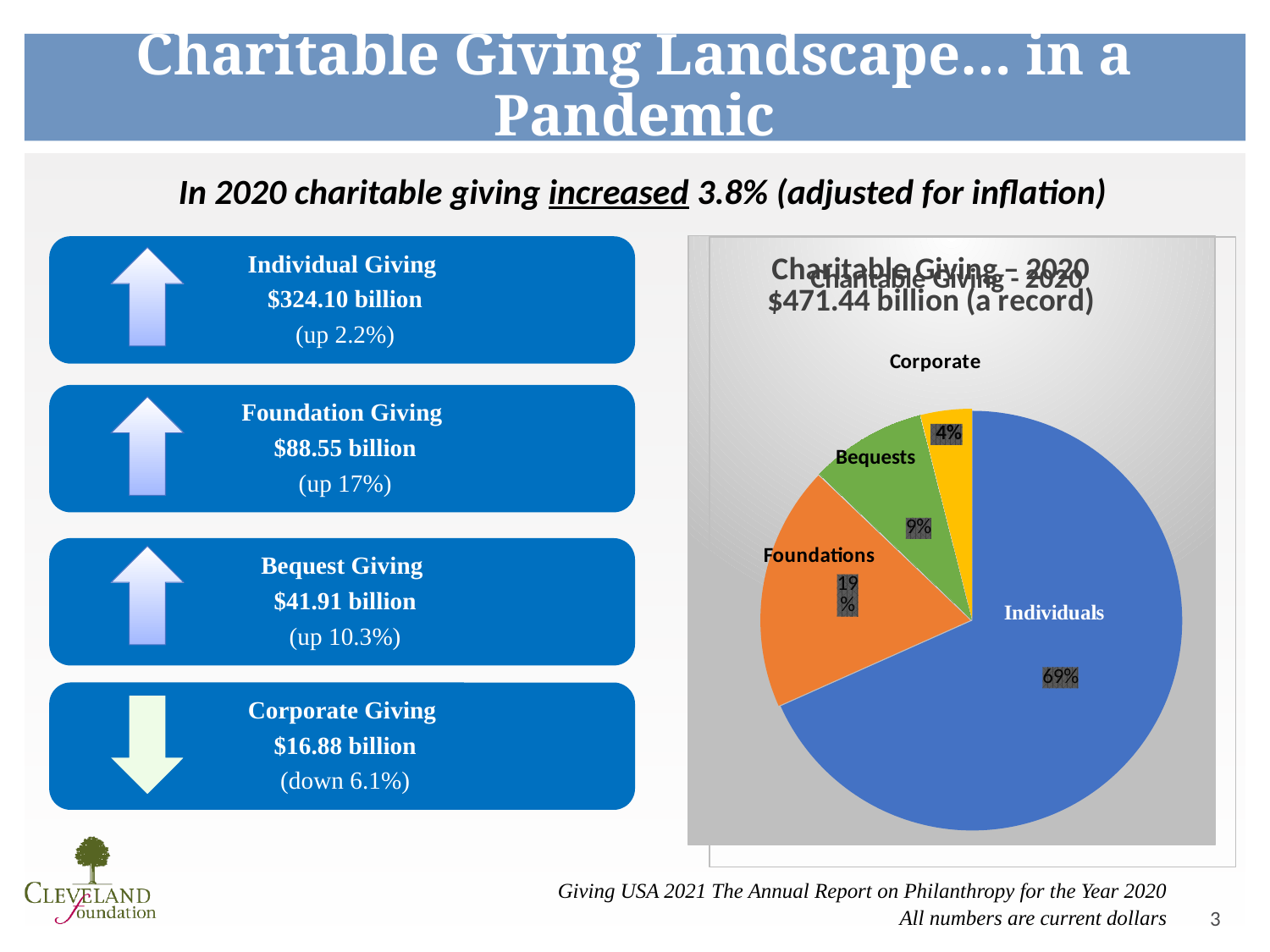
What share of the pie does the Foundations slice represent? 19% What share of the pie does the Bequests slice represent? 9% Which is larger in the pie chart, Foundations or Bequests? Foundations What share of the pie does the Corporate slice represent? 4% Which slice of the pie chart is the smallest? Corporate What is the title of the pie chart? Charitable Giving – 2020 $471.44 billion (a record) What colour is the Individuals slice in the pie chart? blue What kind of chart is shown on the slide? pie chart Which slice of the pie chart is the largest? Individuals How many slices does the pie chart have? 4 What is the difference in percentage points between the Individuals slice and the Foundations slice? 50